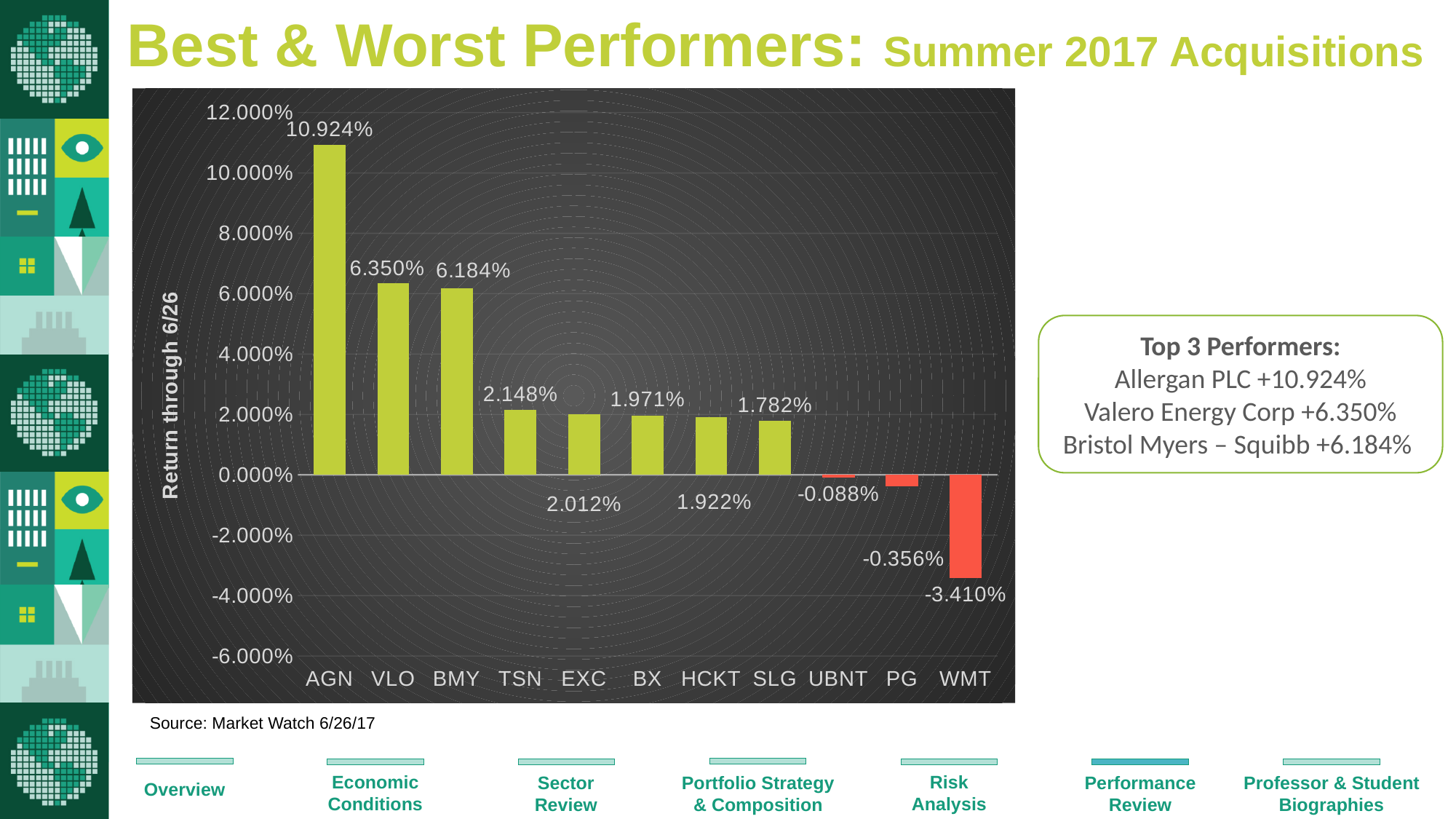
What is the label on the vertical axis of the chart? Return through 6/26 Is the value for BMY greater or less than 8.000%? less What is the difference between the returns of VLO and BMY? 0.166% What is the return for TSN? 2.148% What is the return for WMT? -3.410% Which ticker has the lowest return? WMT How many tickers are shown on the x axis? 11 What kind of chart is shown on the slide? Bar chart Which ticker has the highest return? AGN Which has a larger return, AGN or VLO? AGN What is the return for PG? -0.356% What is the return for AGN? 10.924%